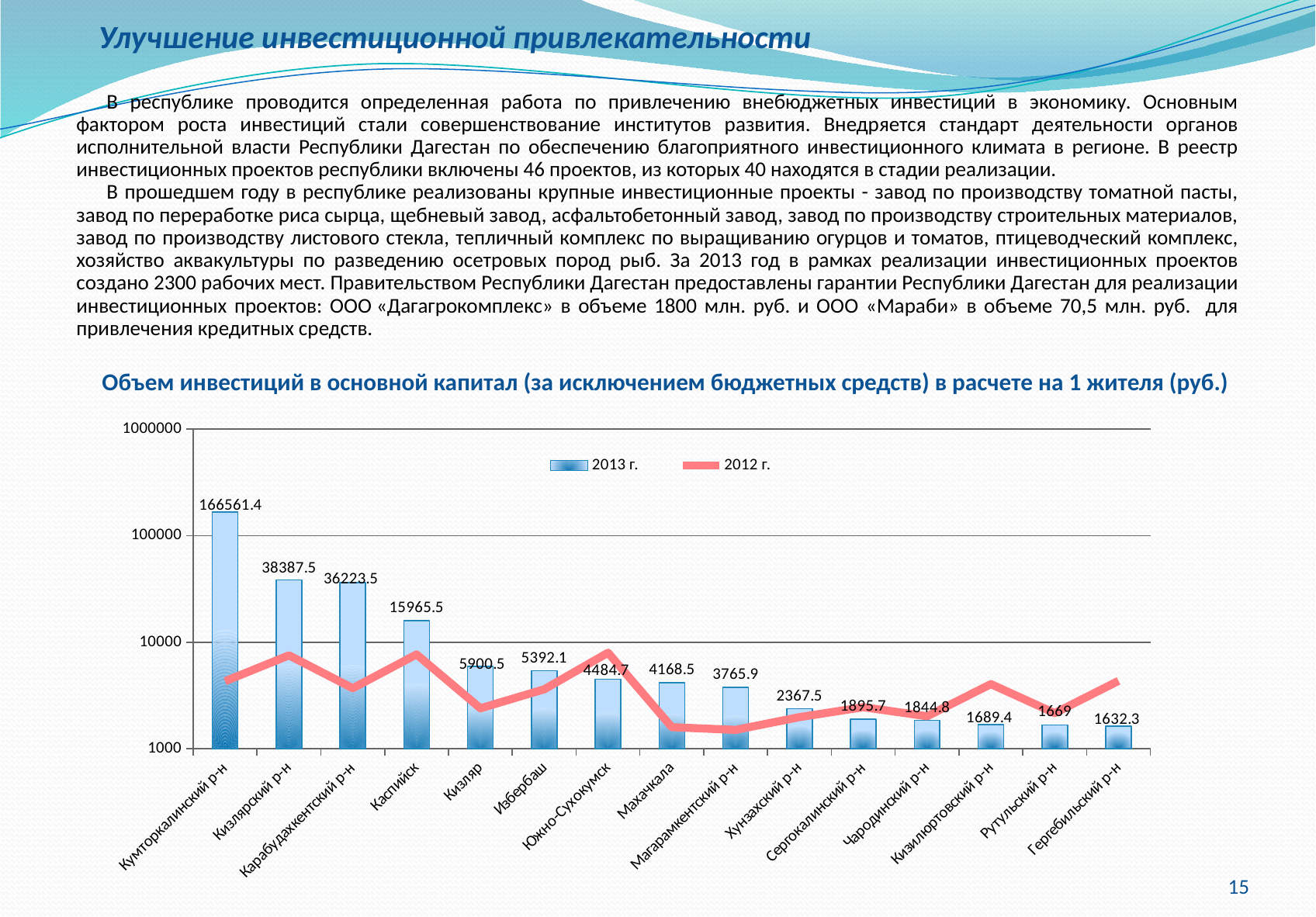
Which has the larger 2013 value, Кизляр or Избербаш? Кизляр What kind of chart is shown on the slide? Bar chart with a line Which category has the highest 2013 value? Кумторкалинский р-н Do the 2013 bar values rise or fall from left to right along the x axis? Fall What is the 2013 value for Махачкала? 4168.5 How many categories are shown on the x axis? 15 Which category has the lowest 2013 value? Гергебильский р-н Is the 2012 value for Кумторкалинский р-н greater or less than 10000? less How many series does the legend list? 2 What is the 2013 value for Каспийск? 15965.5 What is the difference between the 2013 values for Кизлярский р-н and Карабудахкентский р-н? 2164 What is the 2013 value for Кумторкалинский р-н? 166561.4